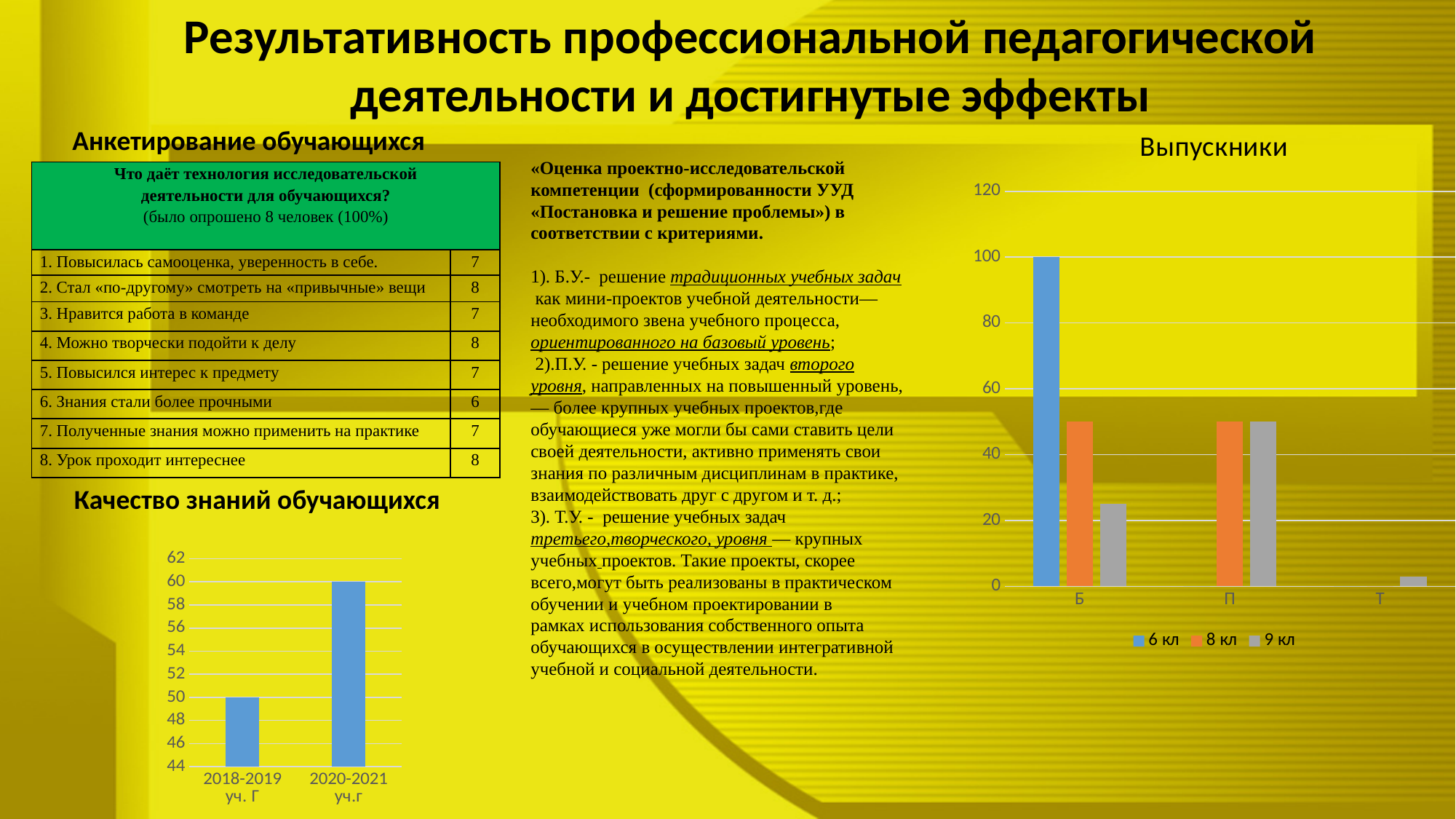
How many categories are shown on the x axis of the chart titled «Выпускники»? 3 In the chart titled «Выпускники», which series has the highest value in category Б? 6 кл In the chart titled «Качество знаний обучающихся», what is the difference between the values for 2020-2021 уч.г and 2018-2019 уч. Г? 10 In the chart titled «Выпускники», which is larger: the value for 9 кл in category Б or in category П? П In the chart titled «Выпускники», what is the value for 6 кл in category Б? 100 In the chart titled «Выпускники», is the value for 9 кл in category Б greater or less than 40? less How many series does the legend of the chart titled «Выпускники» list? 3 What kind of chart is the chart titled «Качество знаний обучающихся»? bar chart In the chart titled «Выпускники», is the value for 8 кл in category Б greater or less than 40? greater In the chart titled «Качество знаний обучающихся», what is the value for 2020-2021 уч.г? 60 In the chart titled «Качество знаний обучающихся», what is the value for 2018-2019 уч. Г? 50 In the chart titled «Качество знаний обучающихся», do the values rise or fall from 2018-2019 to 2020-2021? rise